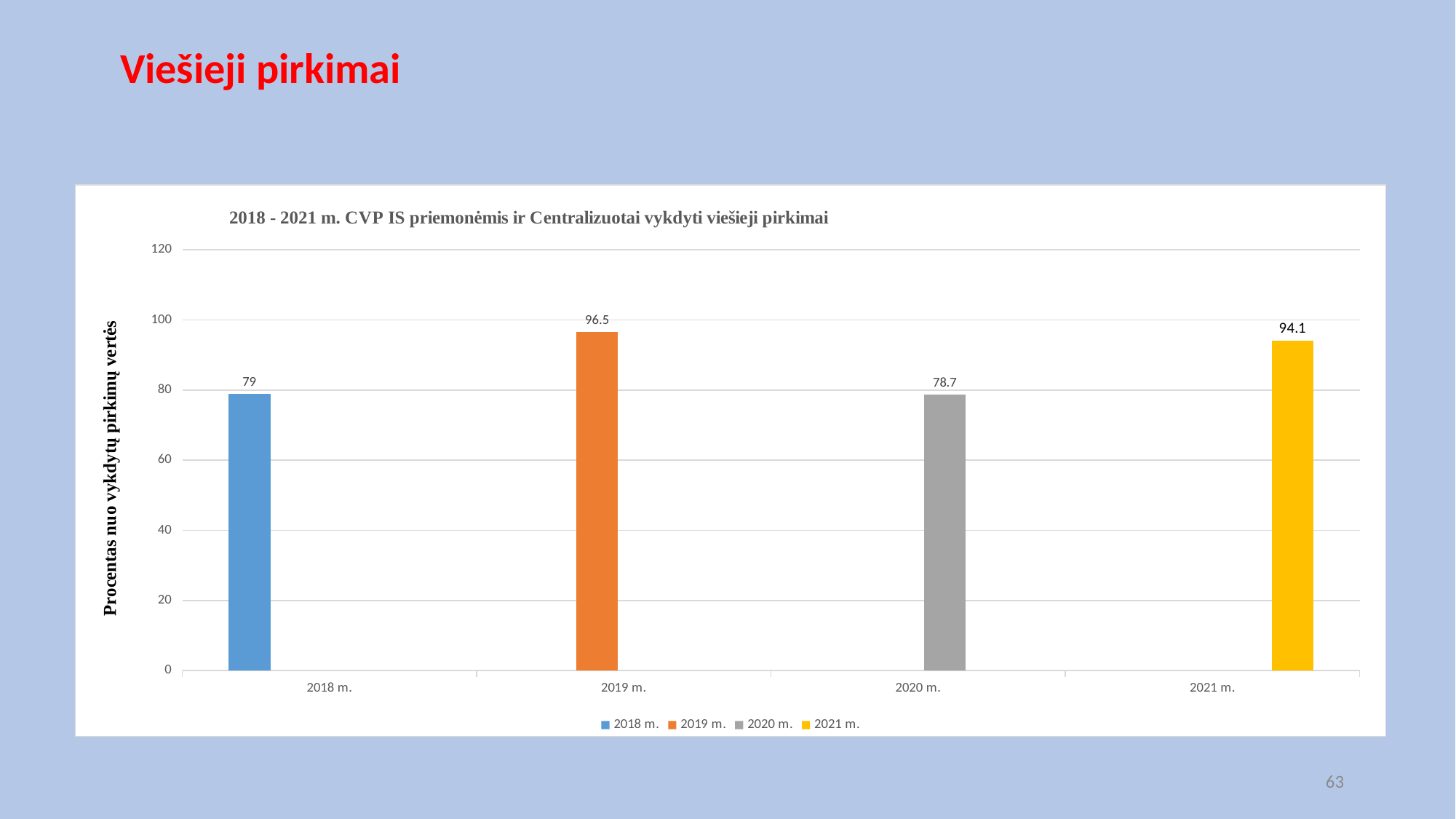
What is the value for 2018 m.? 79 Which year has the highest value? 2019 m. What is the title of the chart? 2018 - 2021 m. CVP IS priemonėmis ir Centralizuotai vykdyti viešieji pirkimai What is the value for 2021 m.? 94.1 What is the value for 2019 m.? 96.5 Which year has the lowest value? 2020 m. What kind of chart is shown on the slide? bar chart What is the value for 2020 m.? 78.7 Is the value for 2019 m. greater or less than 100? less How many years are shown on the x axis? 4 What is the difference between the values for 2019 m. and 2021 m.? 2.4 Which is larger, the value for 2018 m. or the value for 2021 m.? 2021 m.